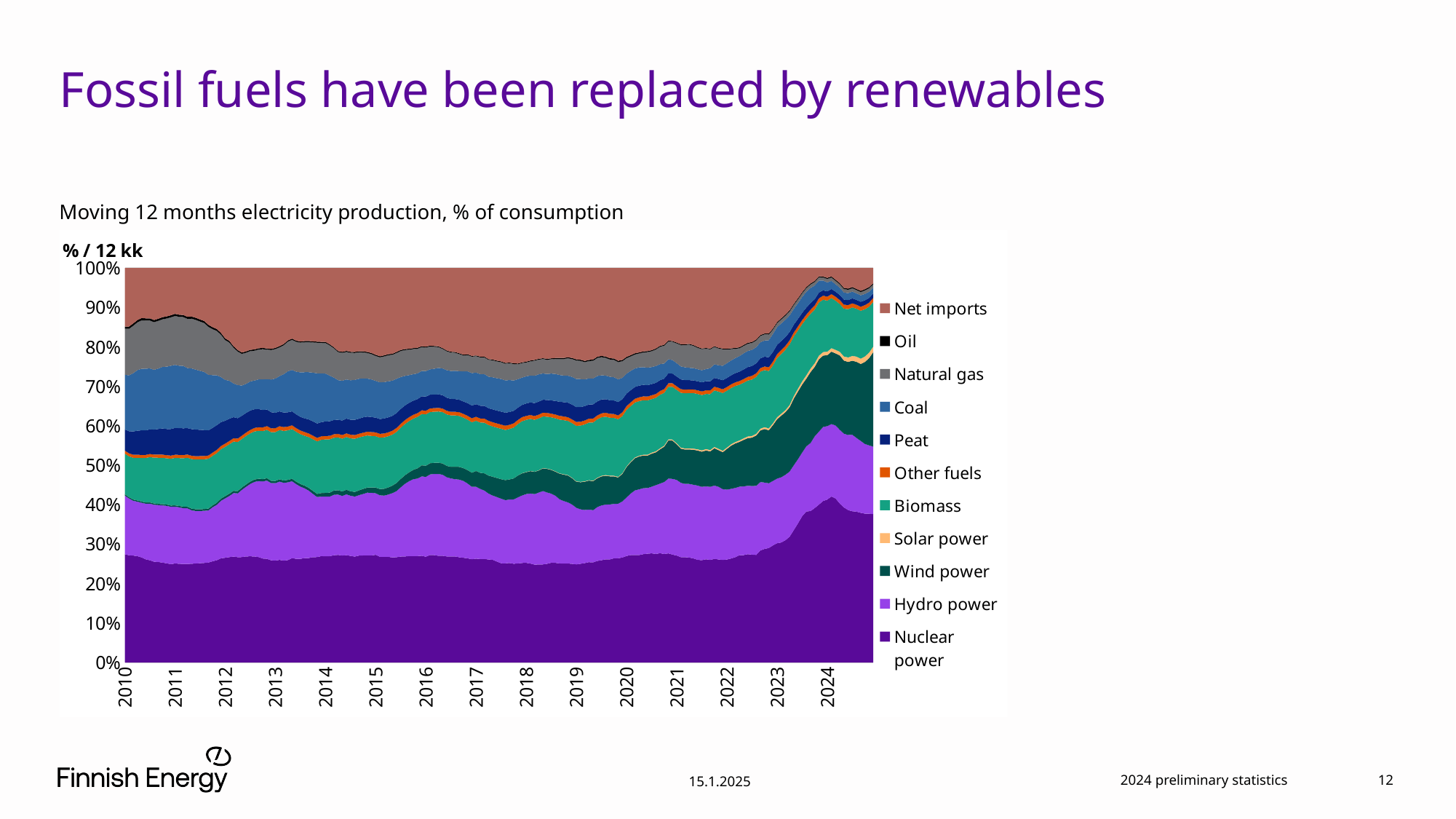
Which series is plotted at the bottom of the stacked area chart? Nuclear power At the end of 2024, which is larger: the share of Nuclear power or the share of Hydro power? Nuclear power Does the share of Wind power rise or fall between 2010 and 2024? rise Which series is plotted at the top of the stacked area chart? Net imports How many year labels are shown along the x axis of the chart? 15 Is the share of Nuclear power at the end of 2024 greater or less than 30%? greater What kind of chart is shown on the slide? Stacked area chart Does the share of Nuclear power rise or fall between 2022 and 2024? rise Is the share of Nuclear power at the start of 2010 greater or less than 20%? greater Does the share of Natural gas rise or fall between 2010 and 2024? fall Is the share of Nuclear power at the start of 2010 greater or less than 30%? less How many series does the chart's legend list? 11